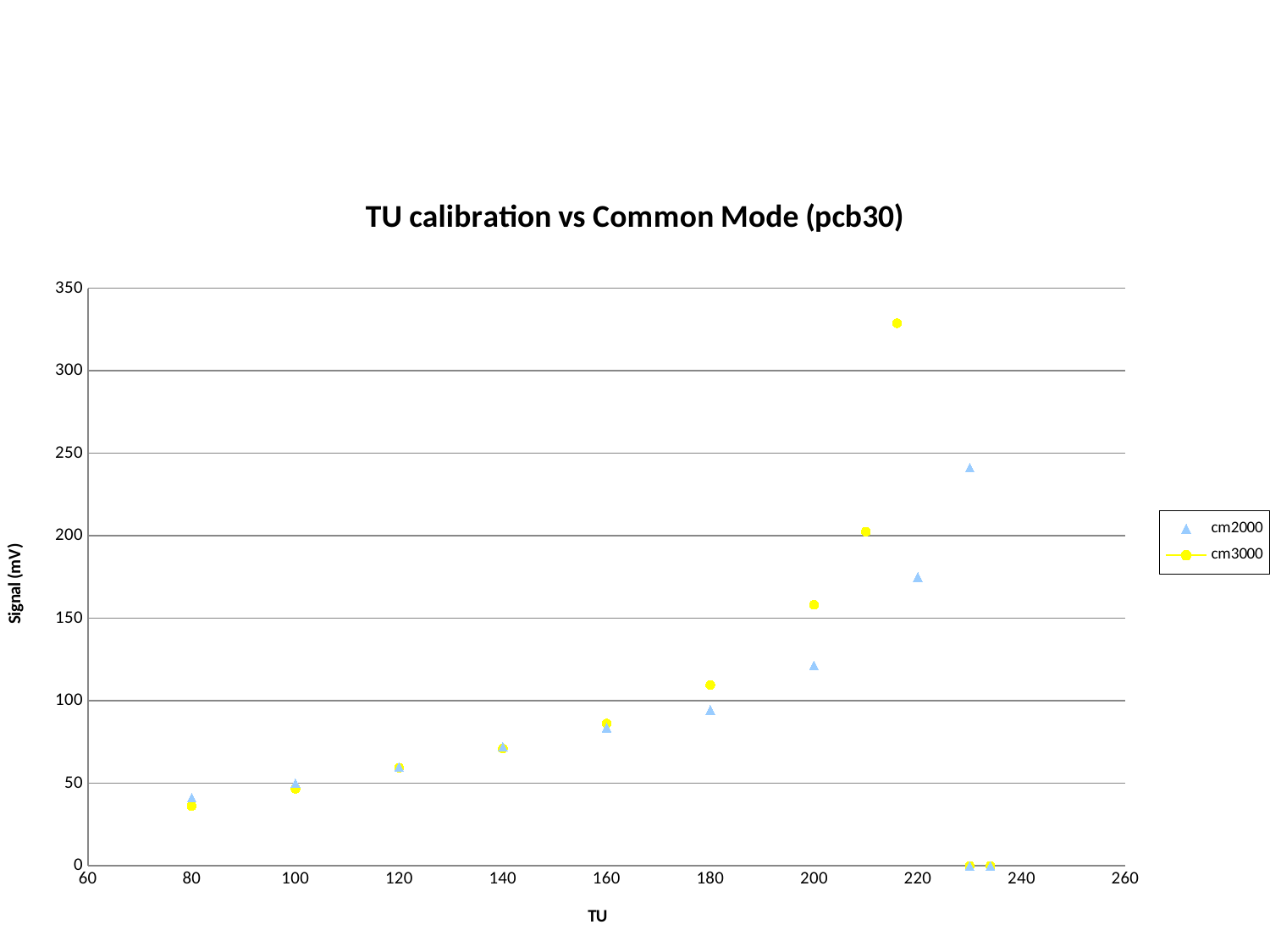
Is the cm2000 value at TU 180 greater or less than 100? less What is the label of the vertical axis? Signal (mV) Is the cm3000 value at TU 180 greater or less than 100? greater Which series reaches the highest signal value on the chart? cm3000 What is the title of the chart? TU calibration vs Common Mode (pcb30) Is the cm2000 value at TU 220 greater or less than 150? greater What kind of chart is shown on the slide? scatter chart How many series does the legend list? 2 At TU 200, which series has the higher signal, cm2000 or cm3000? cm3000